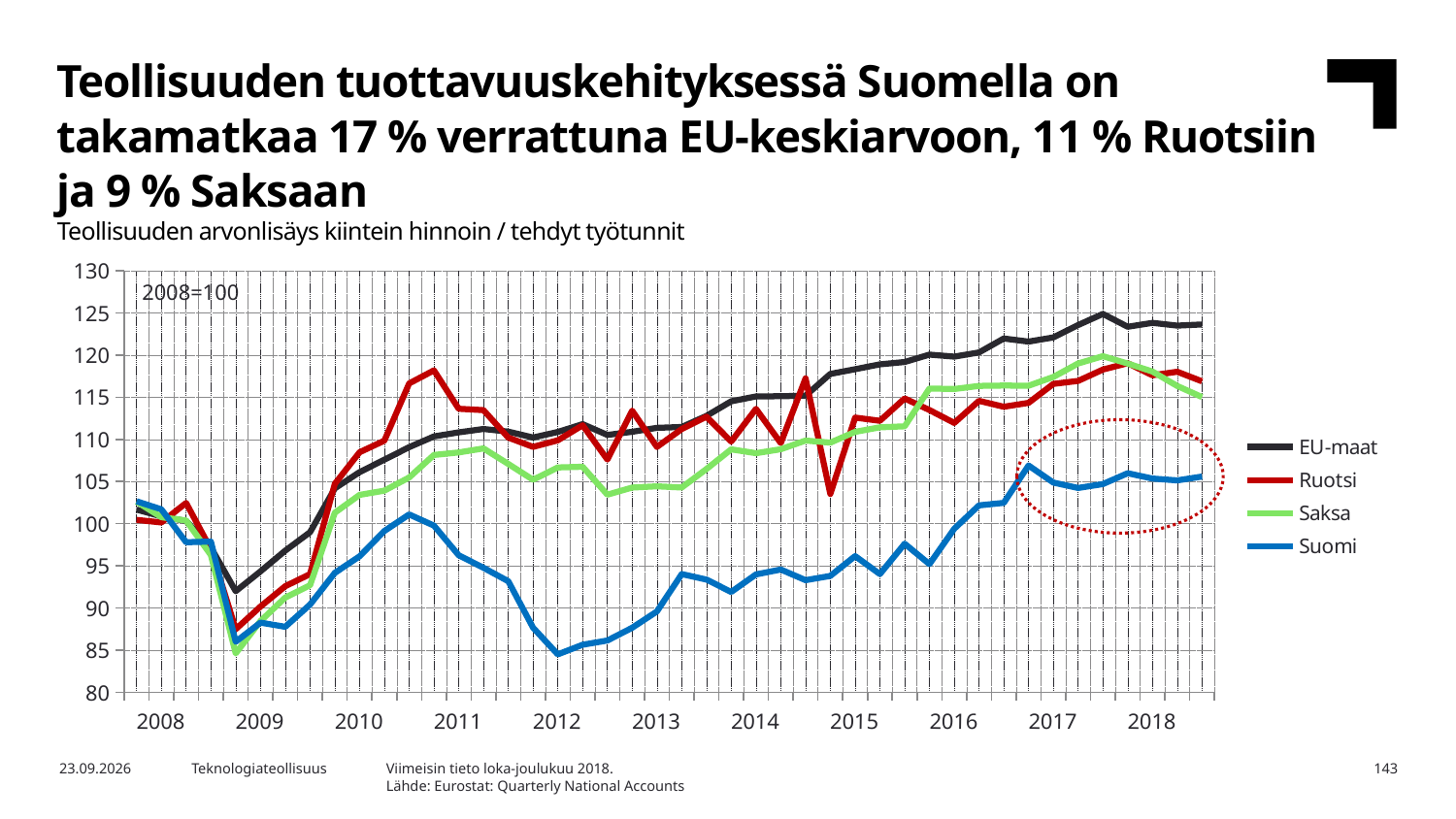
Which series has the lowest value at the end of 2018? Suomi Is the value for Suomi at the end of 2018 greater or less than 110? less At the end of 2018, which is larger: the value for EU-maat or the value for Suomi? EU-maat How many series does the legend list? 4 What kind of chart is shown on the slide? line chart What colour is the Suomi line? blue Does the EU-maat series rise or fall overall from 2010 to 2018? rise Which series has the highest value at the end of 2018? EU-maat What base year and index value is noted on the chart? 2008=100 Is the value for EU-maat at the end of 2018 greater or less than 120? greater Is the value for Saksa at the end of 2018 greater or less than 110? greater